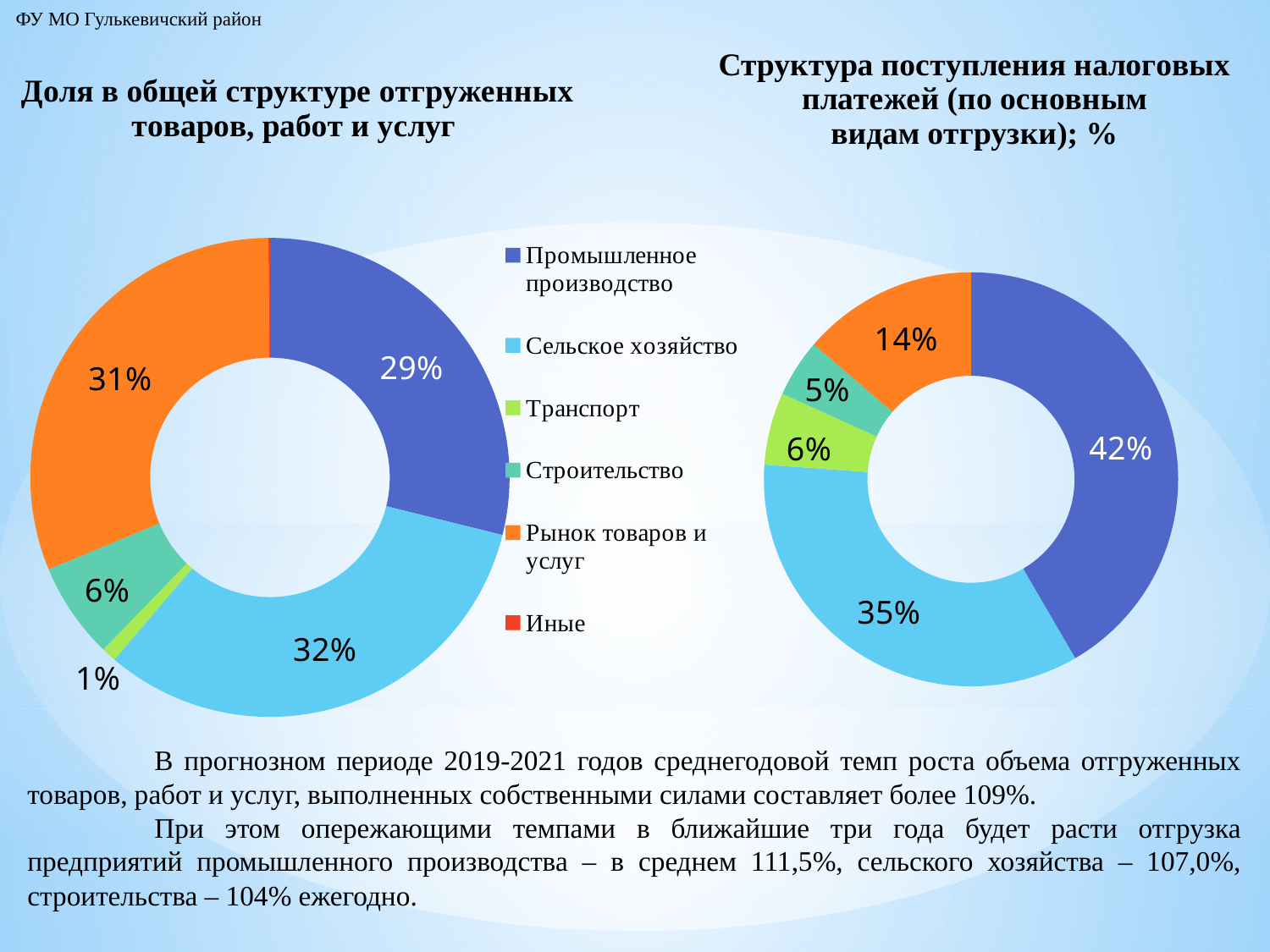
On the right chart (Структура поступления налоговых платежей), what share does Сельское хозяйство have? 35% On the right chart (Структура поступления налоговых платежей), what share does Транспорт have? 6% On the left chart (Доля в общей структуре отгруженных товаров, работ и услуг), what share does Рынок товаров и услуг have? 31% On the right chart (Структура поступления налоговых платежей), which is larger: Рынок товаров и услуг or Строительство? Рынок товаров и услуг On the left chart (Доля в общей структуре отгруженных товаров, работ и услуг), which is larger: Сельское хозяйство or Промышленное производство? Сельское хозяйство On the right chart (Структура поступления налоговых платежей), which category has the largest share? Промышленное производство What type of chart is used on the left side of the slide? Doughnut (pie) chart On the right chart (Структура поступления налоговых платежей), what is the difference in percentage points between Промышленное производство and Сельское хозяйство? 7 On the left chart (Доля в общей структуре отгруженных товаров, работ и услуг), what share does Промышленное производство have? 29% What colour represents Сельское хозяйство in the legend? Light blue On the right chart (Структура поступления налоговых платежей), which category has the smallest share? Строительство